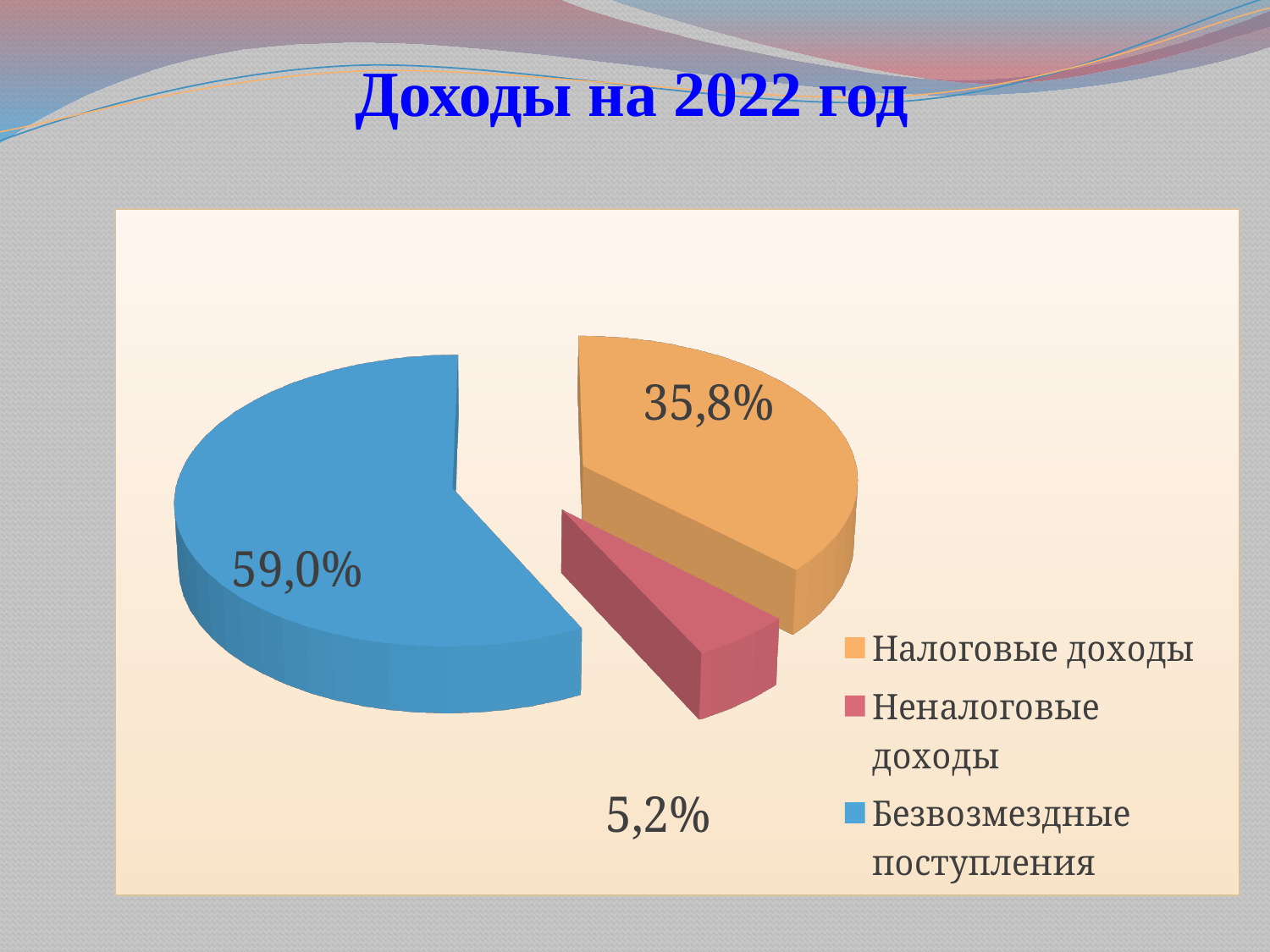
What share of the pie is Неналоговые доходы? 5,2% What is the title of the slide? Доходы на 2022 год Which category has the smallest share of the pie? Неналоговые доходы Which category has the largest share of the pie? Безвозмездные поступления What share of the pie is Безвозмездные поступления? 59,0% How many categories does the pie chart show? 3 Which colour represents Безвозмездные поступления in the pie chart? Blue Which is larger, the share of Налоговые доходы or the share of Неналоговые доходы? Налоговые доходы What share of the pie is Налоговые доходы? 35,8% What kind of chart is shown on the slide? Pie chart What is the difference between the shares of Безвозмездные поступления and Налоговые доходы? 23,2% What is the difference between the shares of Налоговые доходы and Неналоговые доходы? 30,6%